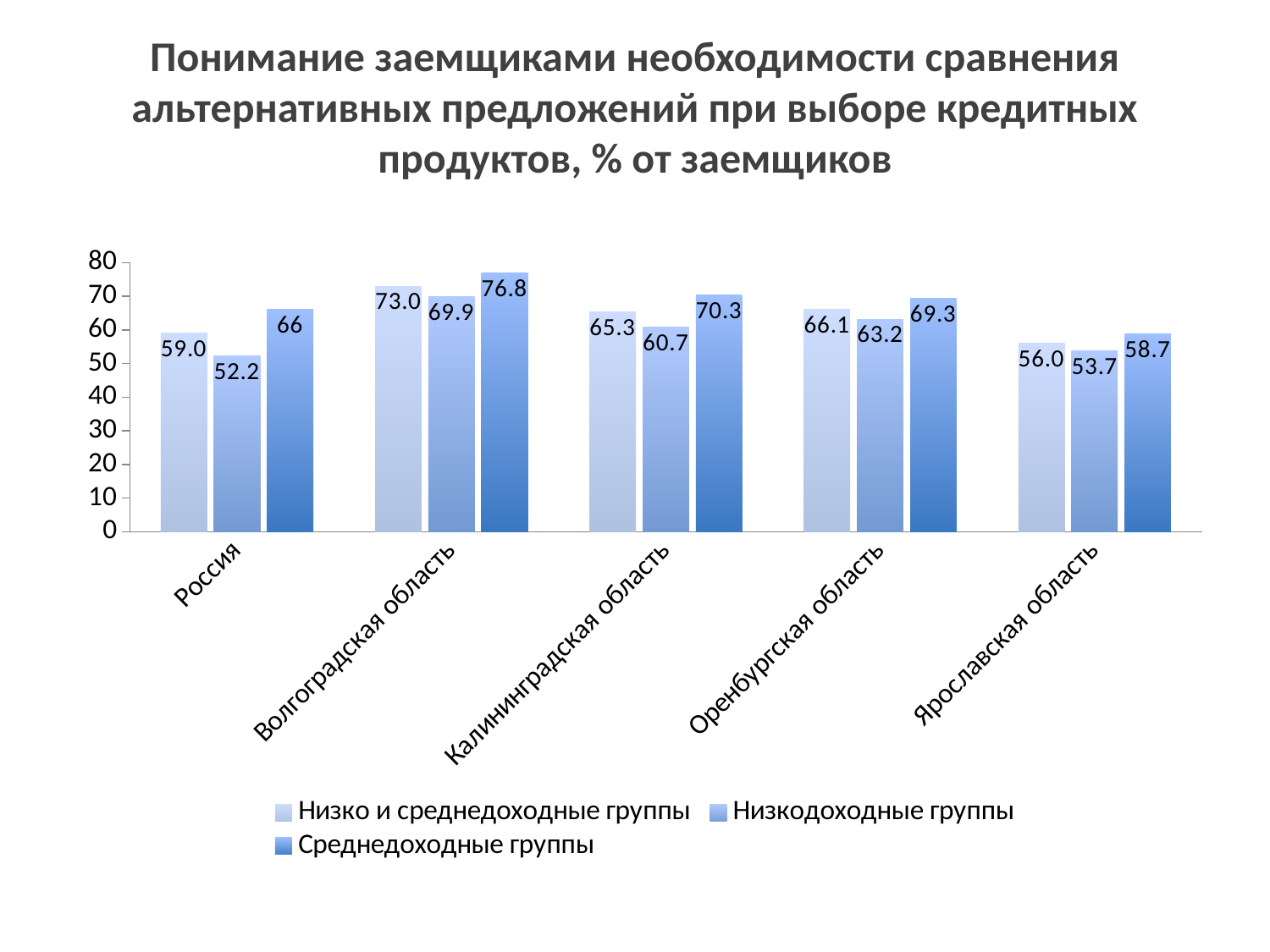
What kind of chart is shown on the slide? bar chart What is the value for Низко и среднедоходные группы in Ярославская область? 56.0 How many categories are shown on the x axis? 5 Which region has the highest value for Среднедоходные группы? Волгоградская область What is the difference between Среднедоходные группы and Низкодоходные группы in Калининградская область? 9.6 Which is larger in Оренбургская область: Низко и среднедоходные группы or Низкодоходные группы? Низко и среднедоходные группы What is the value for Низкодоходные группы in Волгоградская область? 69.9 What is the difference between Низко и среднедоходные группы in Волгоградская область and in Ярославская область? 17.0 Is the value for Низкодоходные группы in Россия greater or less than 60? less What is the value for Среднедоходные группы in Россия? 66 Which category has the lowest value for Низкодоходные группы? Россия How many series does the legend list? 3